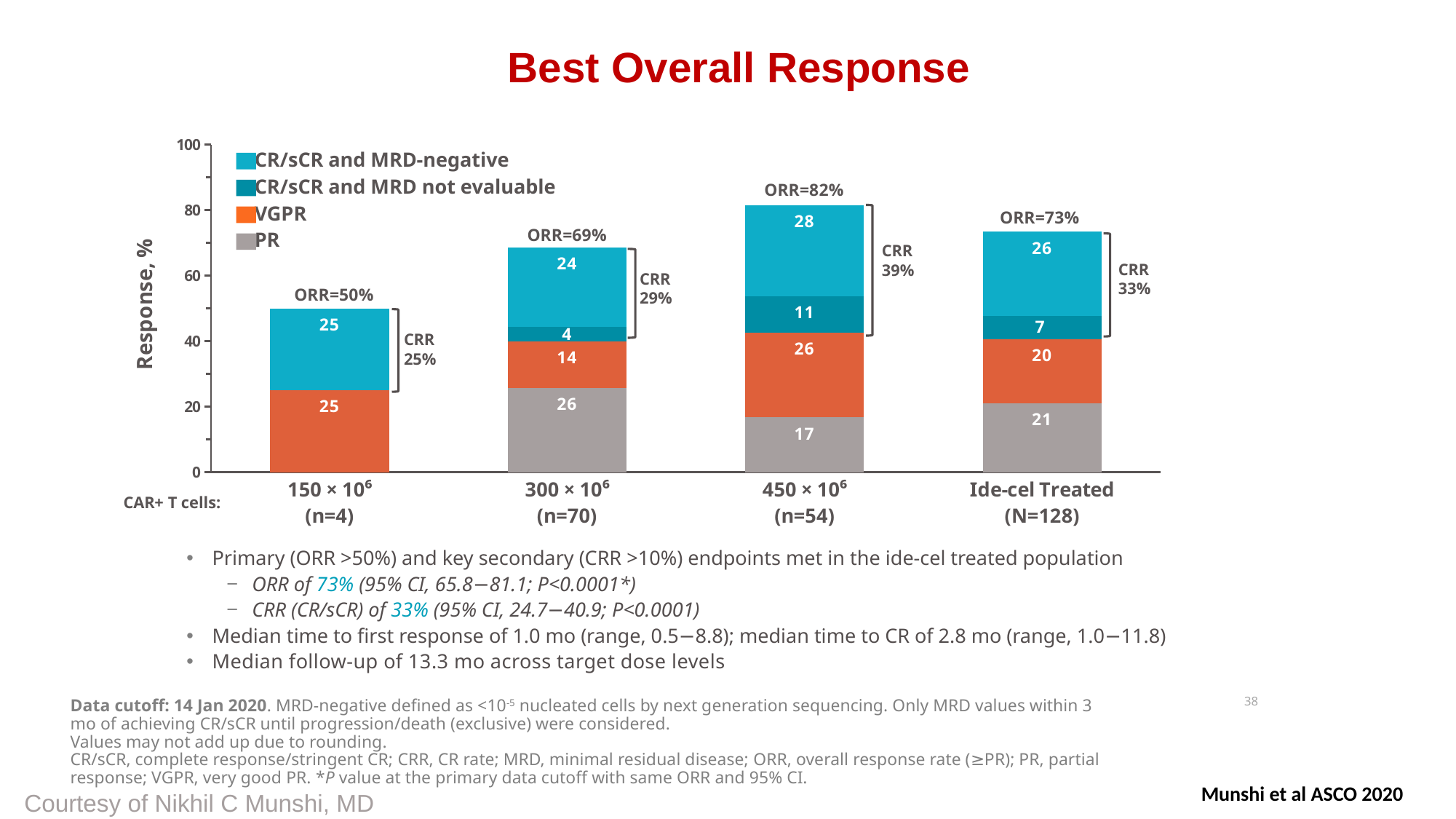
What ORR is shown above the 450 × 10^6 bar? ORR=82% What is the VGPR value for the 300 × 10^6 dose group? 14 What type of chart is shown on the slide? Stacked bar chart Which dose group has the lowest ORR? 150 × 10^6 What is the PR value for the Ide-cel Treated group? 21 What is the CR/sCR and MRD-negative value for the 450 × 10^6 dose group? 28 What is the difference between the CR/sCR and MRD not evaluable values for the 450 × 10^6 and 300 × 10^6 groups? 7 Which is larger, the PR value for the 300 × 10^6 group or the PR value for the 450 × 10^6 group? 300 × 10^6 How many series does the legend list? 4 Which dose group has the highest ORR? 450 × 10^6 What is the y-axis label of the chart? Response, % How many dose groups (bars) are plotted on the x axis? 4